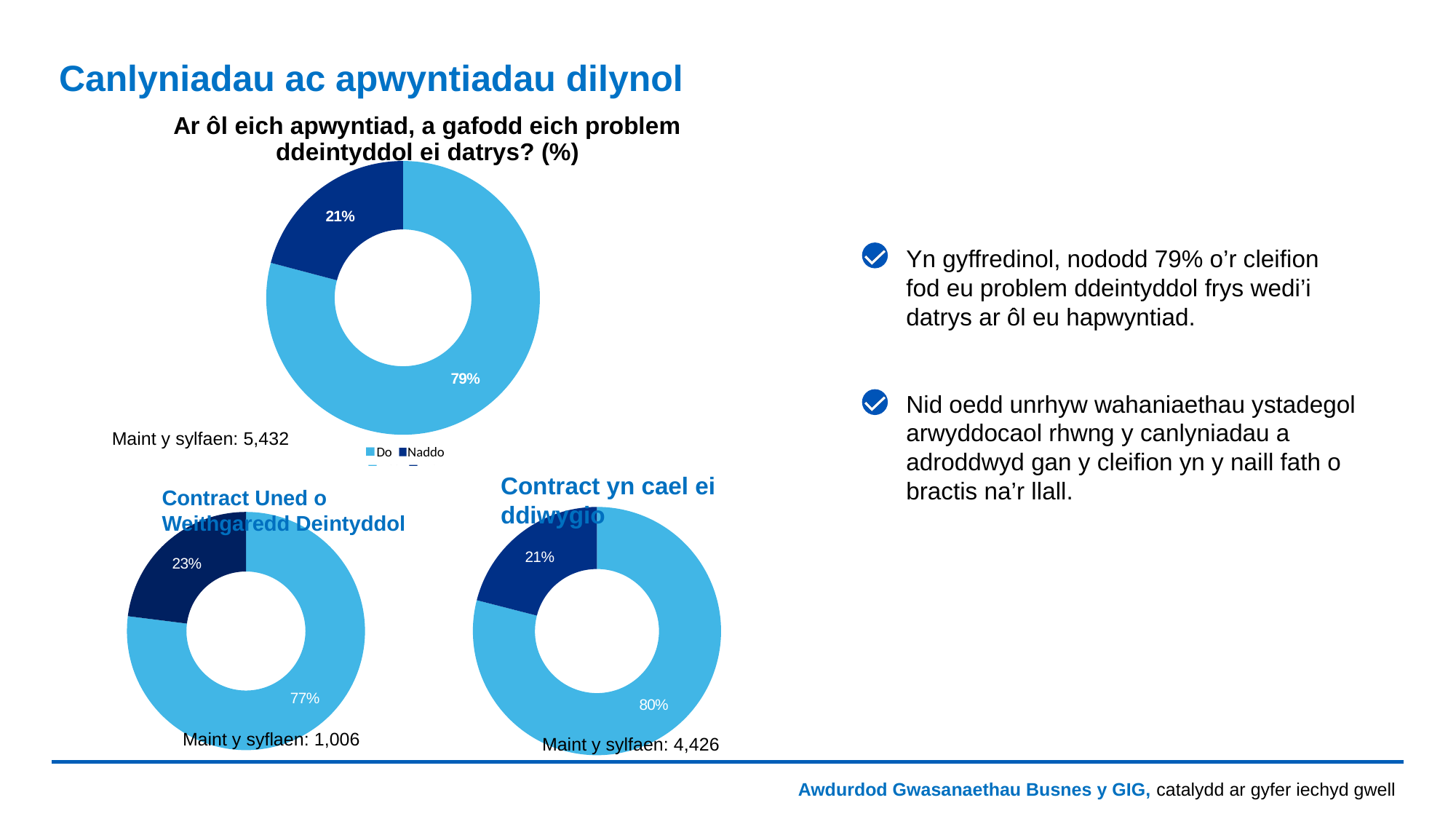
In the bottom-left chart titled 'Contract Uned o Weithgaredd Deintyddol', what percentage is shown for the dark blue slice? 23% In the bottom-right chart titled 'Contract yn cael ei ddiwygio', what percentage is shown for the light blue slice? 80% In the bottom-left chart titled 'Contract Uned o Weithgaredd Deintyddol', what percentage is shown for the light blue slice? 77% In the top chart titled 'Ar ôl eich apwyntiad, a gafodd eich problem ddeintyddol ei datrys? (%)', what percentage is shown for 'Naddo'? 21% In the top chart, what is the difference in percentage points between the 'Do' and 'Naddo' slices? 58 In the bottom-right chart titled 'Contract yn cael ei ddiwygio', what percentage is shown for the dark blue slice? 21% What kind of chart is used on this slide? Pie (doughnut) chart What base size ('Maint y sylfaen') is shown beneath the top chart? 5,432 Which chart shows the larger light blue share: the bottom-left chart 'Contract Uned o Weithgaredd Deintyddol' or the bottom-right chart 'Contract yn cael ei ddiwygio'? Contract yn cael ei ddiwygio In the top chart titled 'Ar ôl eich apwyntiad, a gafodd eich problem ddeintyddol ei datrys? (%)', what percentage is shown for 'Do'? 79% In the top chart, which category has the largest share, 'Do' or 'Naddo'? Do How many entries does the legend of the top chart list? 2